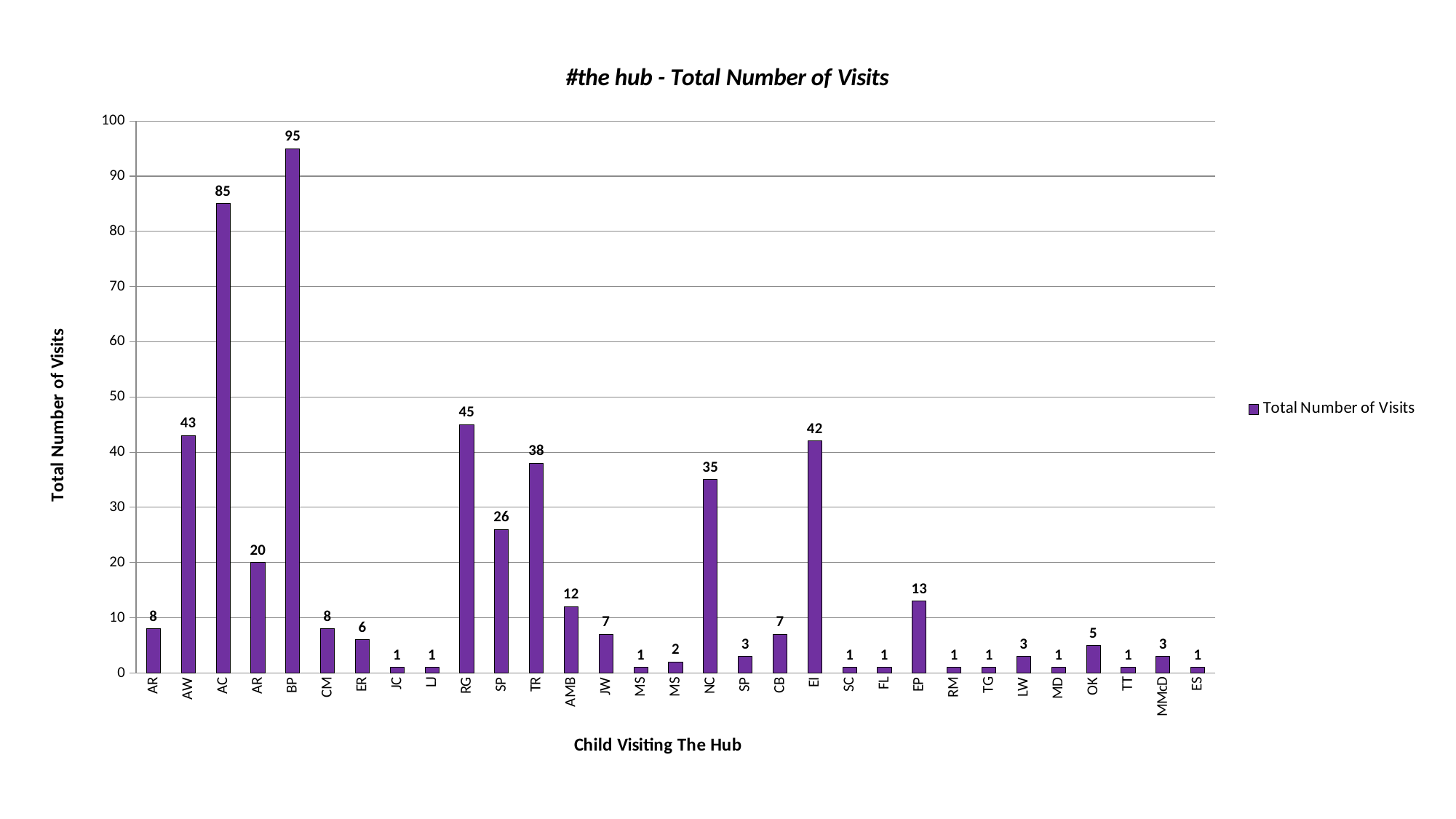
What is the difference in visits between NC and AMB? 23 What is the total number of visits for EP? 13 What is the total number of visits for AC? 85 What type of chart is shown on the slide? Bar chart What is the total number of visits for EI? 42 How many series does the legend list? 1 How many children (categories) are shown on the x axis? 31 What is the total number of visits for BP? 95 What is the title of the chart? #the hub - Total Number of Visits What is the difference in visits between BP and AC? 10 Which has more visits, RG or TR? RG Which child has the highest total number of visits? BP